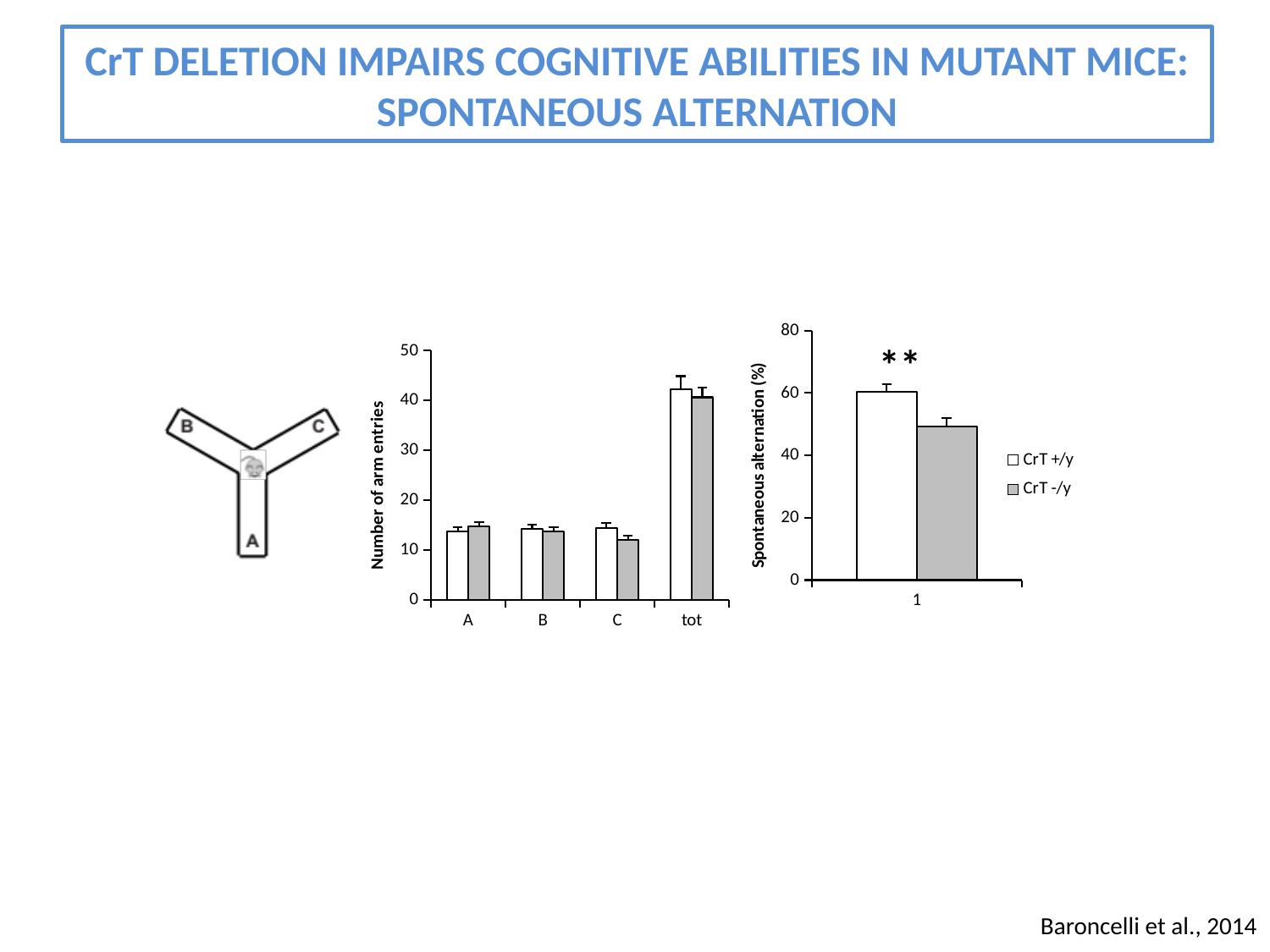
How many categories are shown on the x axis of the left chart, 'Number of arm entries'? 4 In the right chart, 'Spontaneous alternation (%)', is the value for CrT -/y greater or less than 60? less What are the two legend entries shown next to the right chart? CrT +/y and CrT -/y In the right chart, 'Spontaneous alternation (%)', which series has the larger value: CrT +/y or CrT -/y? CrT +/y In the left chart, 'Number of arm entries', is the CrT +/y value for tot greater or less than 30? greater In the left chart, 'Number of arm entries', which category has the highest bars? tot In the right chart, 'Spontaneous alternation (%)', is the value for CrT +/y greater or less than 40? greater What kind of chart is the left chart, 'Number of arm entries'? bar chart How many series does the legend list for the right chart, 'Spontaneous alternation (%)'? 2 What is the y-axis title of the right chart? Spontaneous alternation (%) In the left chart, 'Number of arm entries', which is larger: the CrT +/y value for tot or the CrT +/y value for A? tot